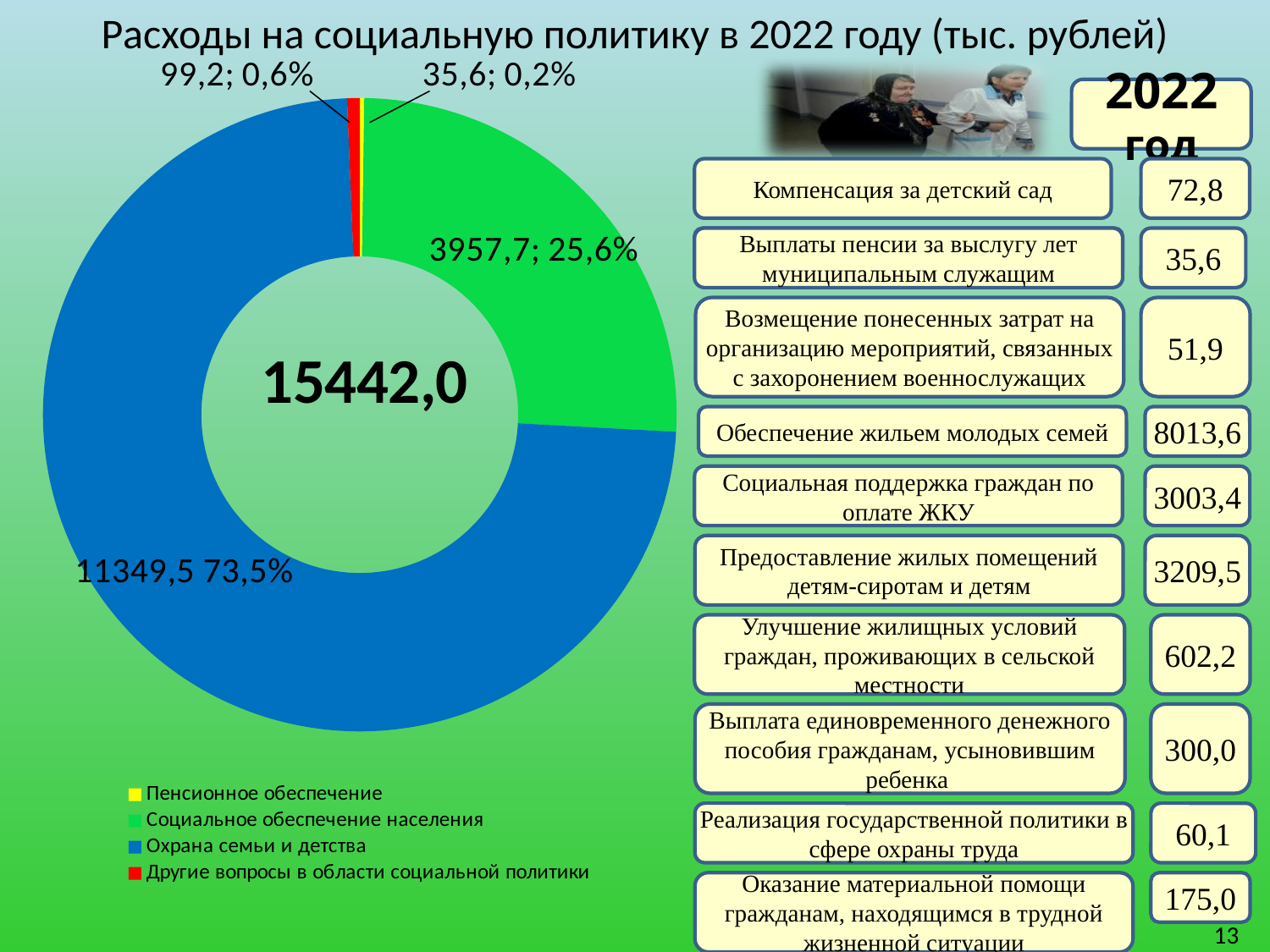
What is the value for Социальное обеспечение населения? 3957,7 What total value is shown in the centre of the chart? 15442,0 What share of the chart does Другие вопросы в области социальной политики take? 0,6% What share of the chart does Социальное обеспечение населения take? 25,6% What share of the chart does Охрана семьи и детства take? 73,5% How many categories does the chart's legend list? 4 What kind of chart is shown on the slide? doughnut (pie) chart What is the difference between the values for Охрана семьи и детства and Социальное обеспечение населения? 7391,8 What is the value for Охрана семьи и детства? 11349,5 Which category has the smallest slice? Пенсионное обеспечение Which category has the largest slice? Охрана семьи и детства What is the value for Пенсионное обеспечение? 35,6